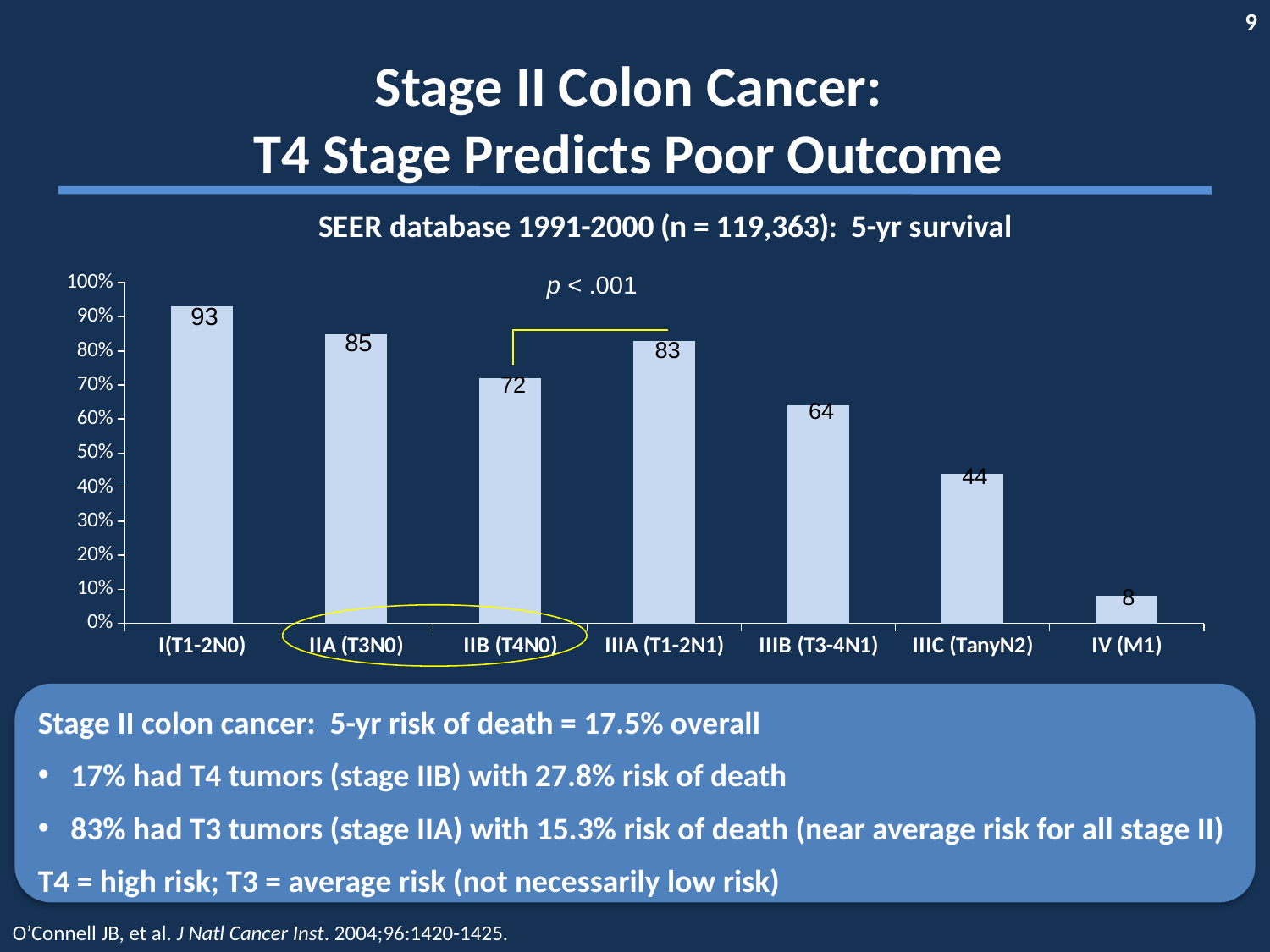
Is the value for IIIB (T3-4N1) greater or less than 70%? less What is the 5-yr survival value shown for stage I(T1-2N0)? 93 Which is larger, the value for IIB (T4N0) or IIIA (T1-2N1)? IIIA (T1-2N1) How many stage categories are shown on the x axis? 7 What is the value shown for stage IIB (T4N0)? 72 What is the value shown for stage IIIC (TanyN2)? 44 Do the values generally rise or fall from left to right along the x axis? fall Which stage has the lowest 5-yr survival? IV (M1) What kind of chart is shown on the slide? bar chart What p-value is printed above the chart? p < .001 What is the difference between the values for IIA (T3N0) and IIB (T4N0)? 13 Which stage has the highest 5-yr survival? I(T1-2N0)